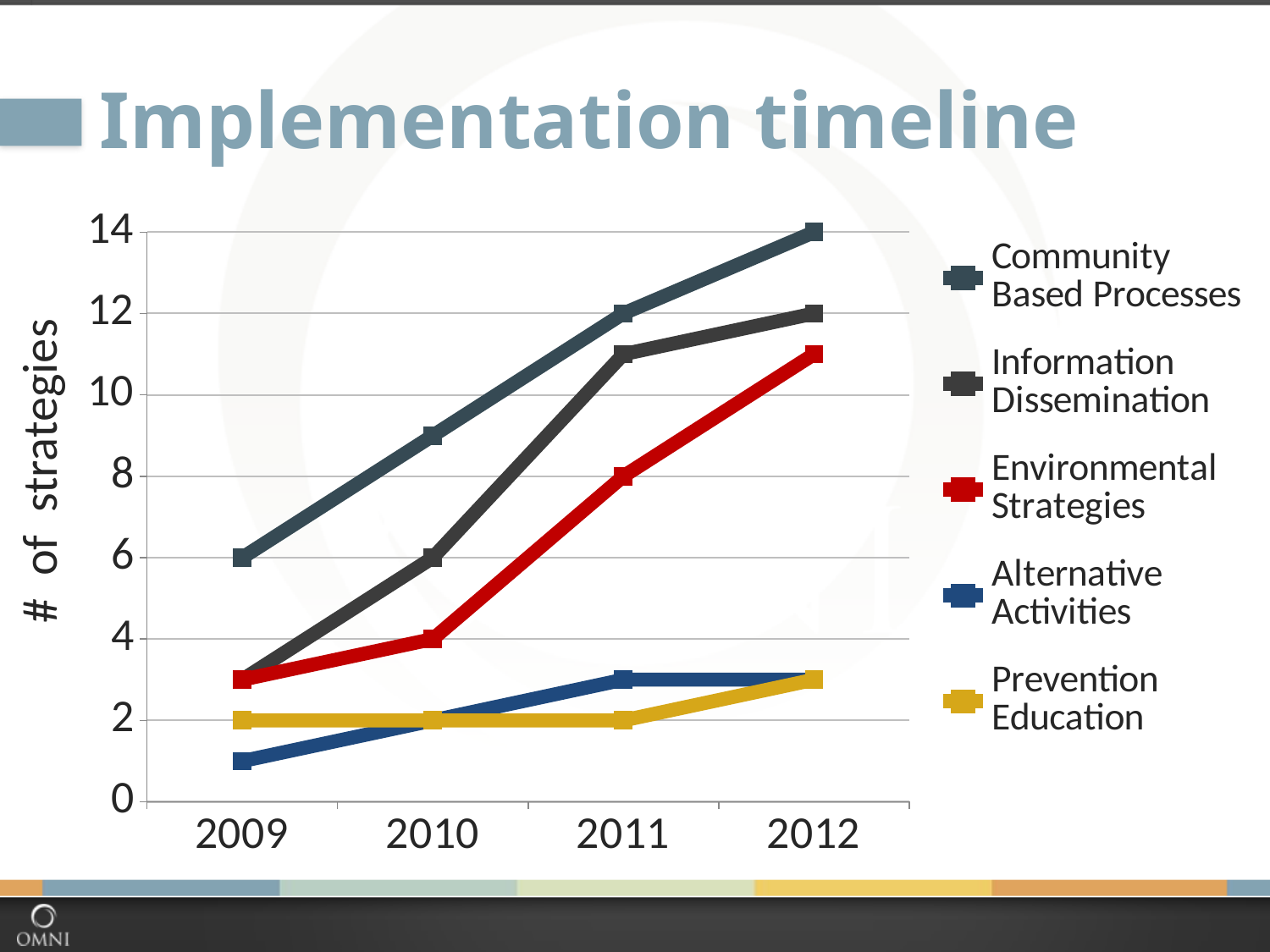
How many series does the legend list? 5 What is the value for Environmental Strategies in 2011? 8 What is the value for Community Based Processes in 2009? 6 Which series has the lowest value in 2009? Alternative Activities What is the value for Information Dissemination in 2012? 12 What type of chart is shown on the slide? line chart Does the Community Based Processes series rise or fall from 2009 to 2012? rise What is the value for Community Based Processes in 2012? 14 How many years are shown on the x axis? 4 Is the value for Information Dissemination in 2011 greater or less than 10? greater Which series has the highest value in 2012? Community Based Processes What is the difference between Community Based Processes and Information Dissemination in 2012? 2